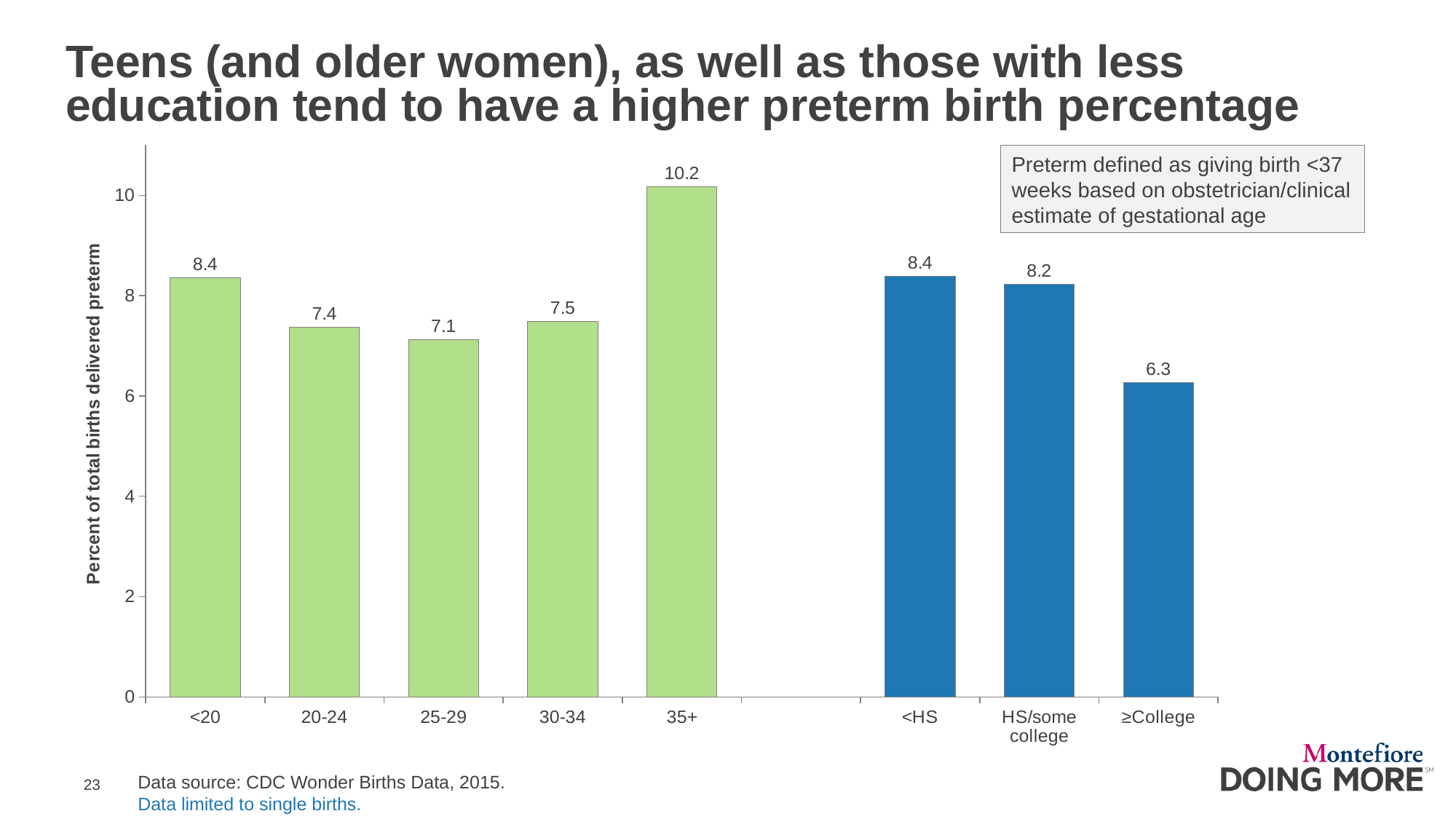
Which age group has the highest preterm birth percentage? 35+ What is the value shown for the 25-29 age group? 7.1 What is the percent of total births delivered preterm for mothers with less than a high school education (<HS)? 8.4 How many categories are plotted on the chart in total? 8 Which education category has the lowest preterm birth percentage? ≥College What is the label of the vertical axis? Percent of total births delivered preterm What is the percent of total births delivered preterm for the 35+ age group? 10.2 What is the difference between the preterm birth percentage for the 35+ age group and the 25-29 age group? 3.1 Which has a higher preterm birth percentage, the <20 age group or the 20-24 age group? <20 What is the difference between the preterm birth percentage for <HS and ≥College? 2.1 Is the value for the ≥College category greater or less than 8? less What kind of chart is shown on the slide? bar chart